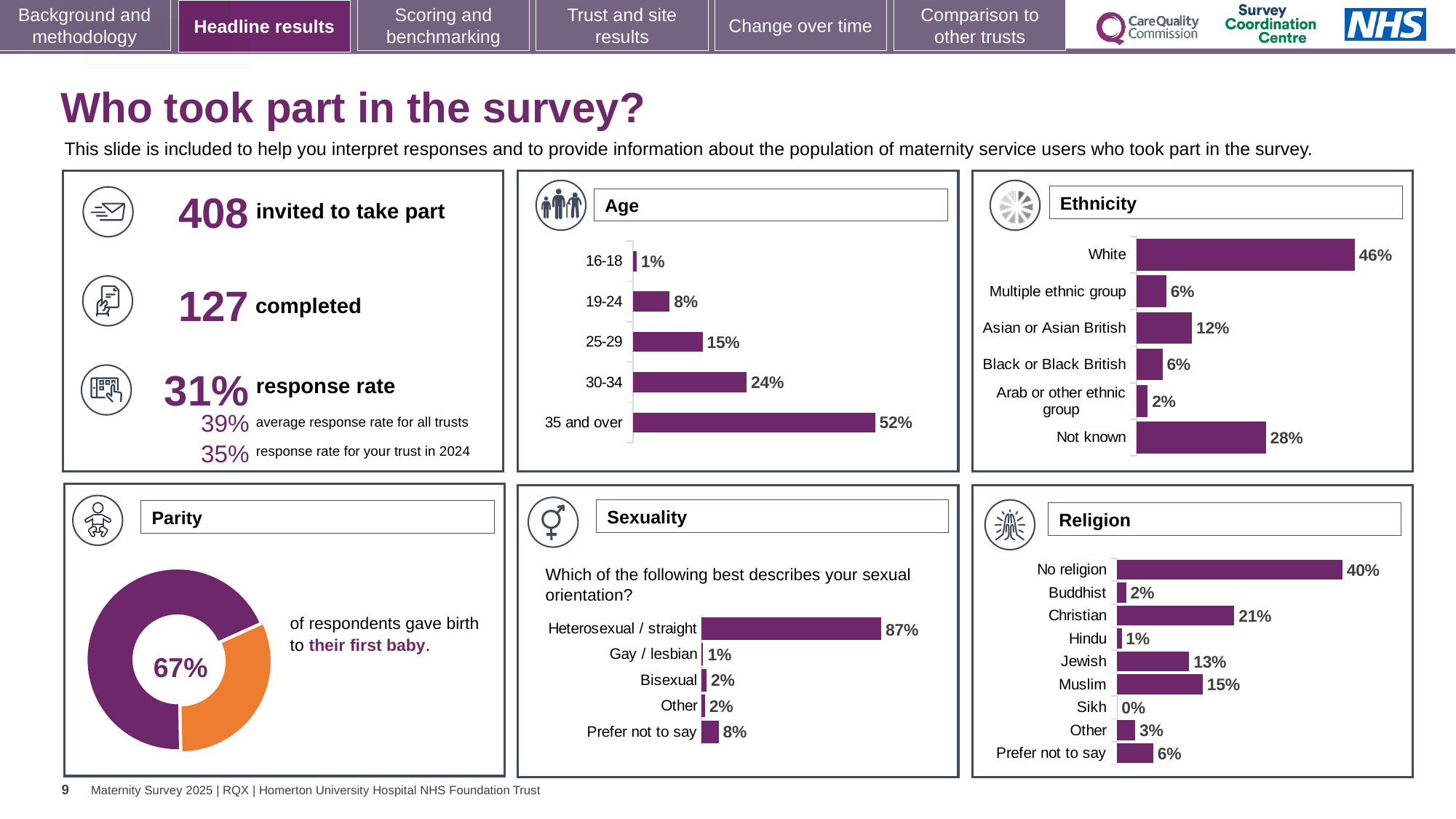
In the Age chart, what percentage of respondents were aged 35 and over? 52% In the Age chart, which age group has the lowest percentage? 16-18 In the Ethnicity chart, what is the difference between the percentage for White and the percentage for Not known? 18% In the Sexuality chart, what percentage of respondents answered Heterosexual / straight? 87% In the Ethnicity chart, what percentage of respondents were White? 46% In the Religion chart, how many categories are shown? 9 In the Age chart, how many age categories are shown? 5 What kind of chart is the Parity chart? Doughnut chart In the Sexuality chart, what is the difference between Prefer not to say and Bisexual? 6% In the Ethnicity chart, which is larger: Asian or Asian British or Black or Black British? Asian or Asian British In the Religion chart, which category has the highest percentage? No religion In the Parity chart, what percentage of respondents gave birth to their first baby? 67%